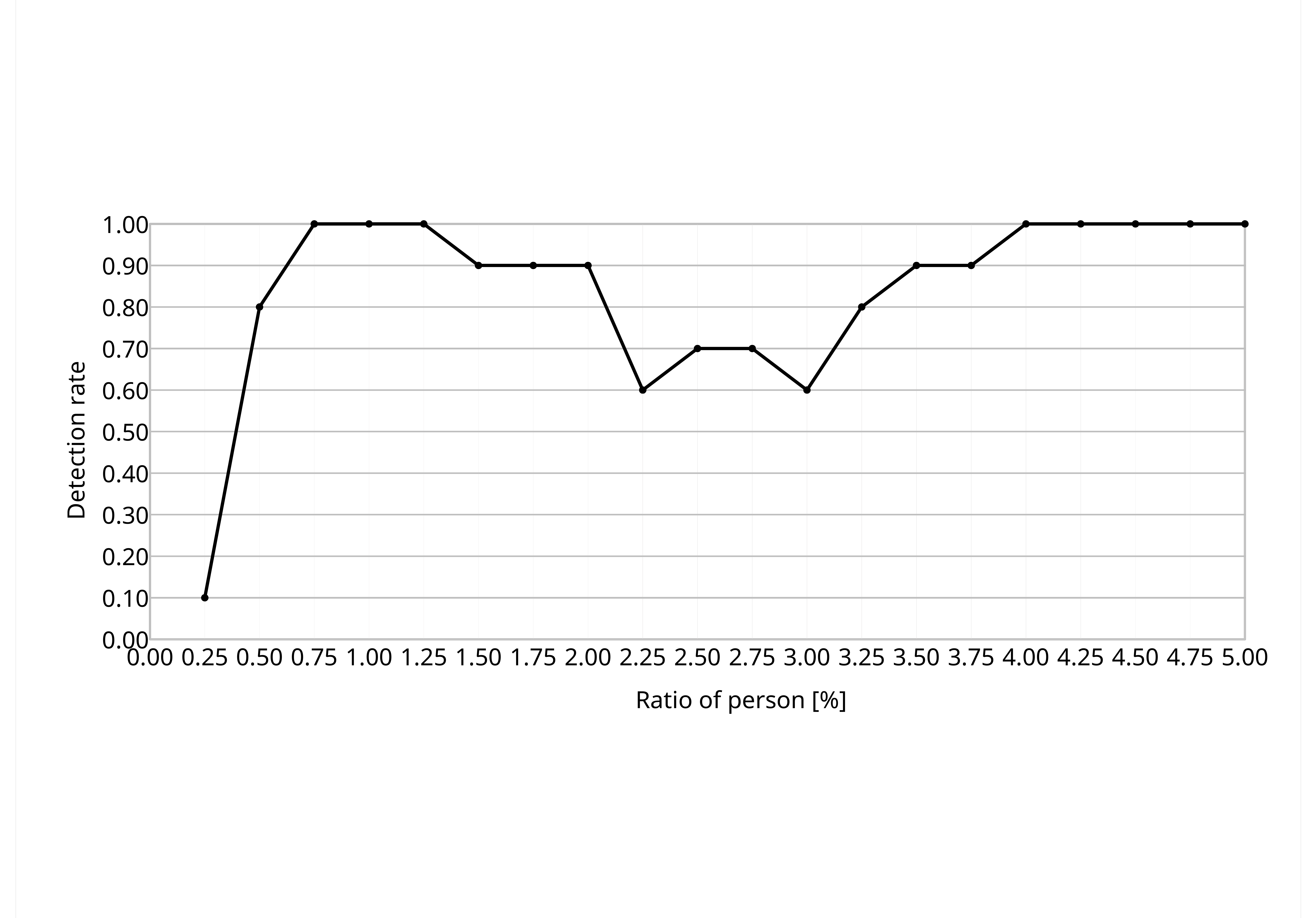
What is the detection rate at a ratio of person of 0.25%? 0.10 Does the detection rate rise or fall between a ratio of person of 0.25% and 0.75%? rise What is the detection rate at a ratio of person of 3.25%? 0.80 What is the detection rate at a ratio of person of 2.25%? 0.60 What is the difference between the detection rate at 0.75% and at 0.25%? 0.90 How many data points are plotted on the line? 20 At which ratio of person is the detection rate lowest? 0.25 What is the detection rate at a ratio of person of 2.50%? 0.70 What kind of chart is shown on the slide? line chart Which has a higher detection rate: a ratio of person of 2.00% or 2.25%? 2.00 What is the label of the x axis? Ratio of person [%] What is the detection rate at a ratio of person of 0.50%? 0.80